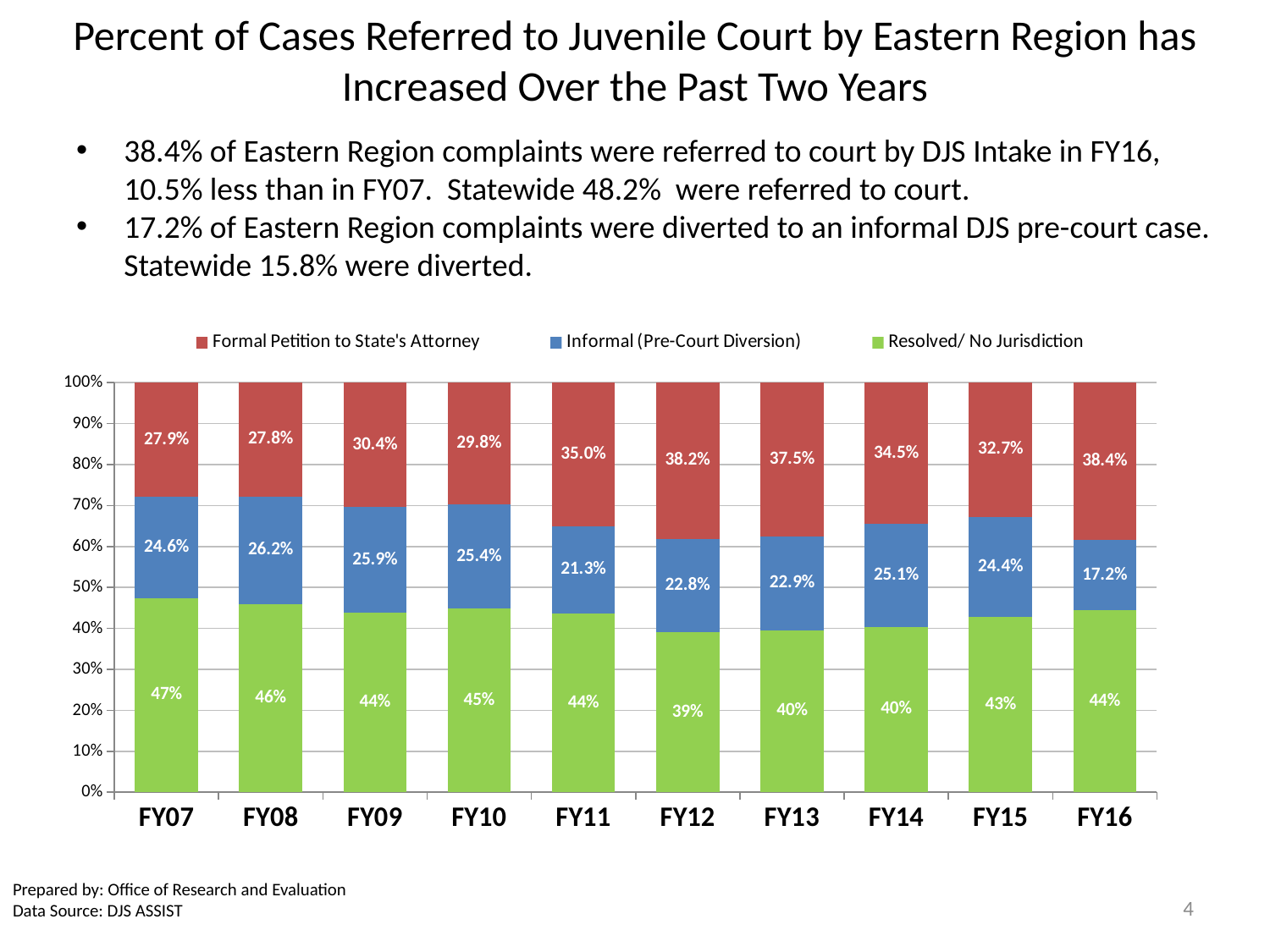
How many series does the legend list? 3 In which fiscal year was the Resolved/ No Jurisdiction share the highest? FY07 What is the difference between the Formal Petition to State's Attorney share in FY16 and in FY07? 10.5% Which colour represents Resolved/ No Jurisdiction in the chart? Green Which is larger: the Informal (Pre-Court Diversion) share in FY15 or in FY16? FY15 What percentage of cases were Informal (Pre-Court Diversion) in FY08? 26.2% In which fiscal year was the Informal (Pre-Court Diversion) share the lowest? FY16 In which fiscal year was the Formal Petition to State's Attorney share the lowest? FY08 What percentage of cases were Resolved/ No Jurisdiction in FY12? 39% What percentage of cases were Formal Petition to State's Attorney in FY16? 38.4% What kind of chart is shown on the slide? Stacked bar chart How many fiscal years are shown on the x axis? 10